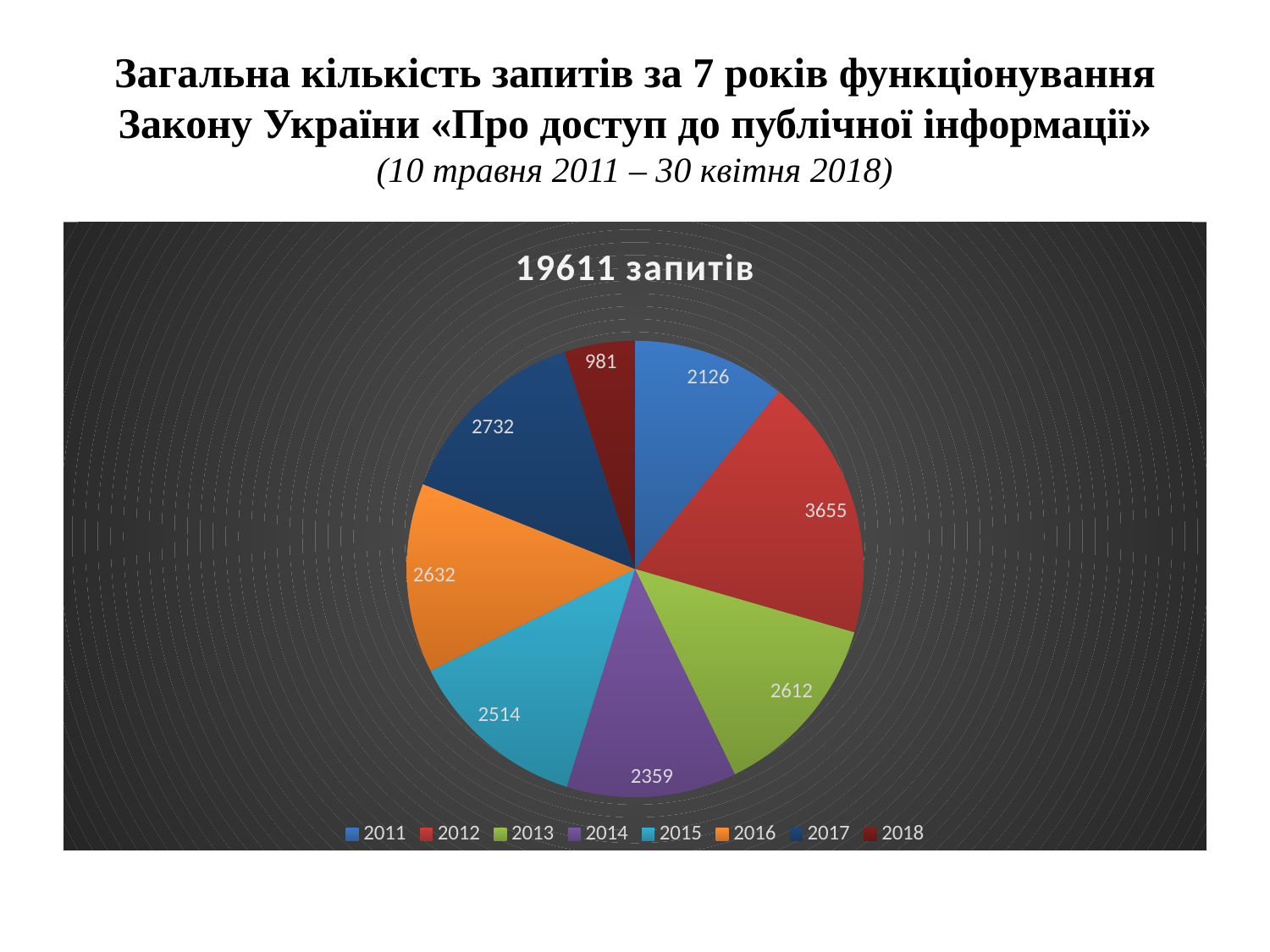
Which year has the smallest number of requests? 2018 What type of chart is shown on the slide? pie chart What is the number of requests for 2015? 2514 What is the title of the chart? 19611 запитів What is the number of requests for 2012? 3655 What is the total number of requests across all years shown? 19611 How many years (slices) does the pie chart show? 8 Which year had more requests, 2017 or 2014? 2017 How many entries does the legend list? 8 What is the number of requests for 2018? 981 What is the difference between the requests in 2012 and 2011? 1529 Which year has the largest number of requests? 2012